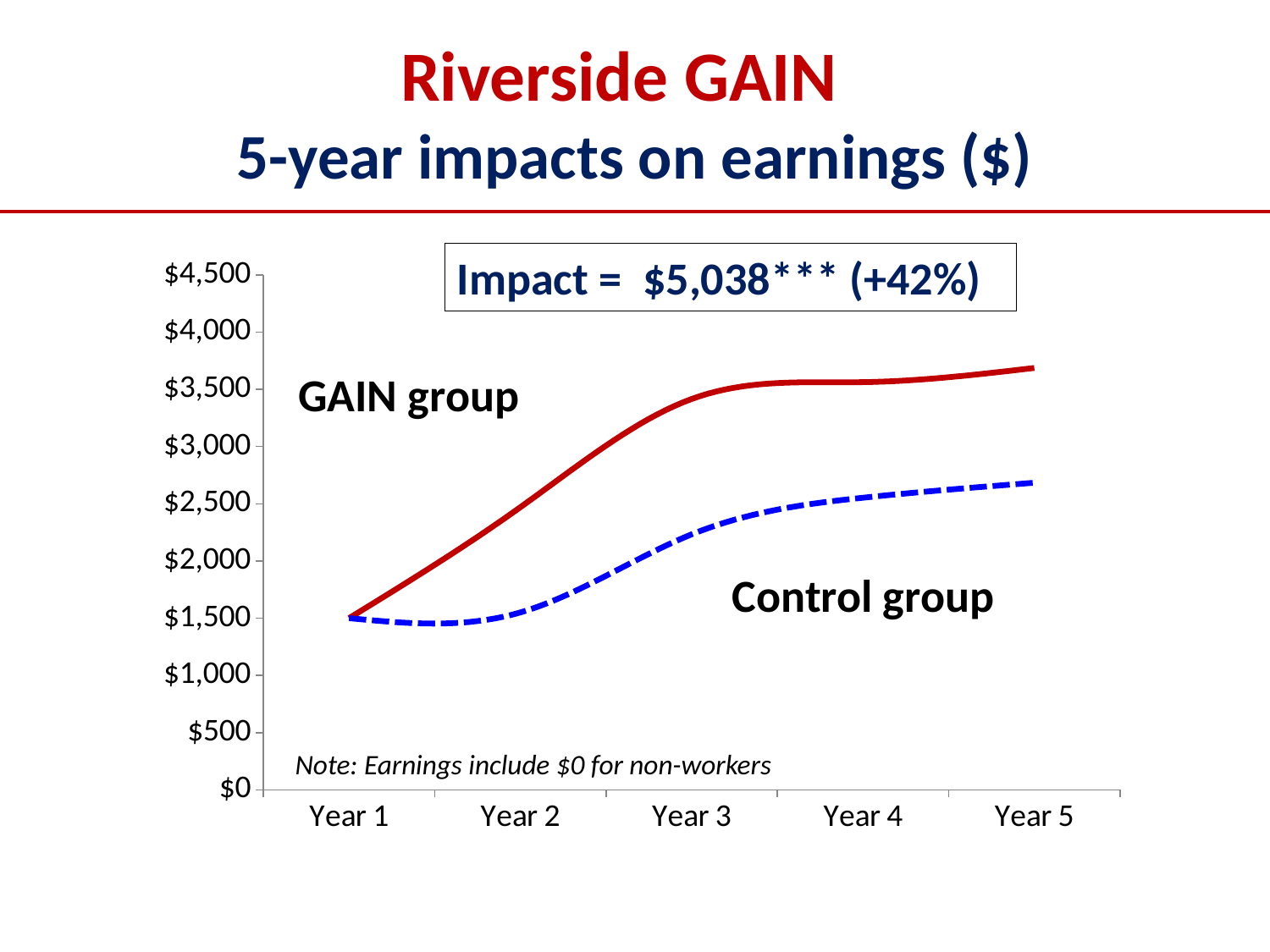
Is the Control group's value in Year 4 greater or less than $2,000? greater What kind of chart is shown on the slide? line chart What impact value is stated in the box on the chart? $5,038*** (+42%) In which year is the GAIN group's earnings value lowest? Year 1 In Year 3, which group has higher earnings, the GAIN group or the Control group? GAIN group Is the Control group's value in Year 2 greater or less than $2,000? less Is the GAIN group's value in Year 3 greater or less than $3,000? greater How many years are shown along the x axis? 5 How many series (groups) are plotted on the chart? 2 Do the GAIN group's earnings rise or fall from Year 1 to Year 5? rise Which group is drawn with a dashed line? Control group